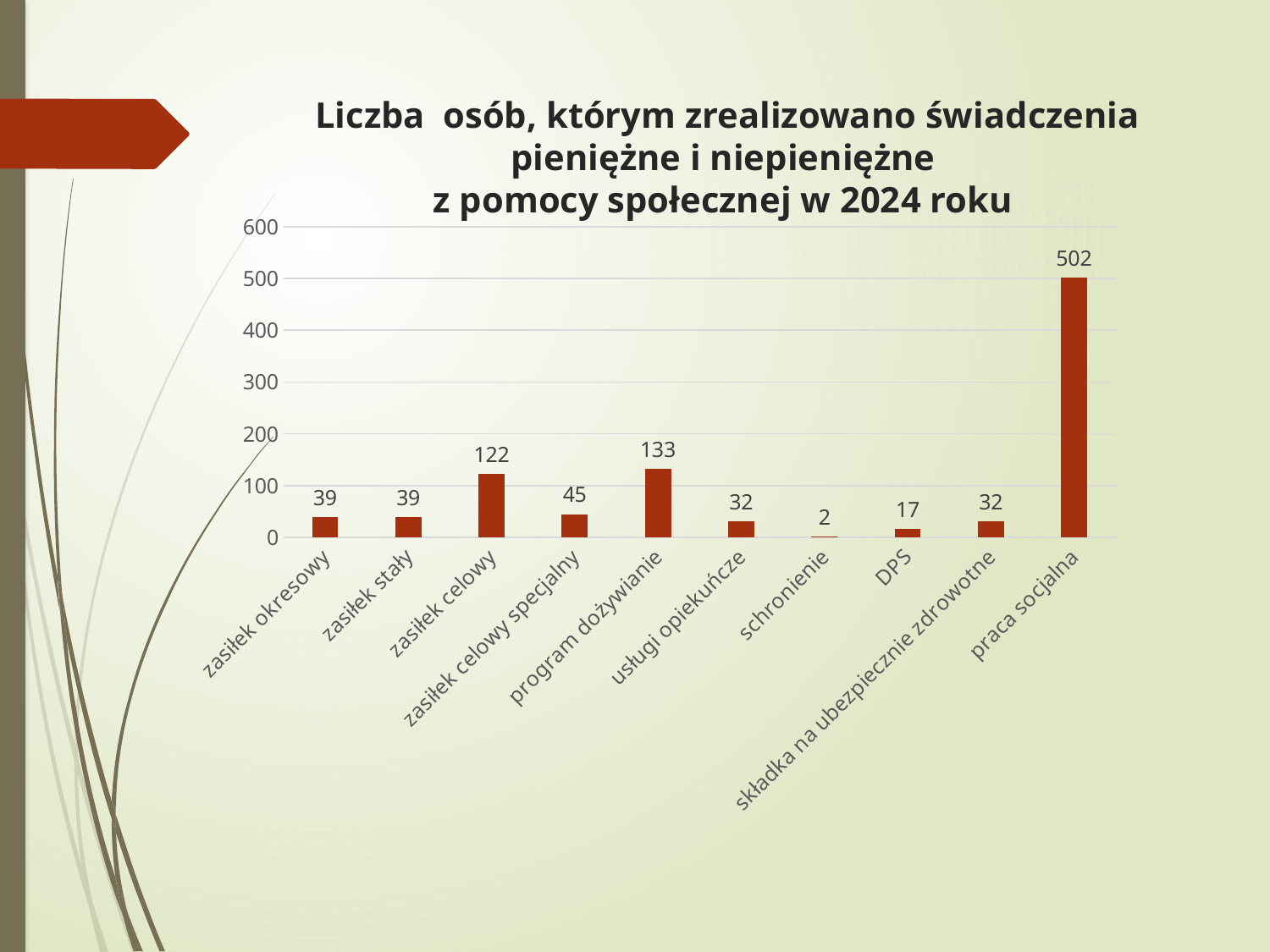
Which category has the lowest value? schronienie What is the difference between the values for praca socjalna and program dożywianie? 369 What is the value for DPS? 17 How many categories are shown on the x axis? 10 What is the value for program dożywianie? 133 What is the value for praca socjalna? 502 Is the value for praca socjalna greater or less than 400? greater Which is larger, the value for zasiłek celowy or the value for program dożywianie? program dożywianie What kind of chart is shown on the slide? bar chart What is the difference between the values for zasiłek celowy and zasiłek celowy specjalny? 77 What is the value for zasiłek celowy specjalny? 45 Which category has the highest value? praca socjalna